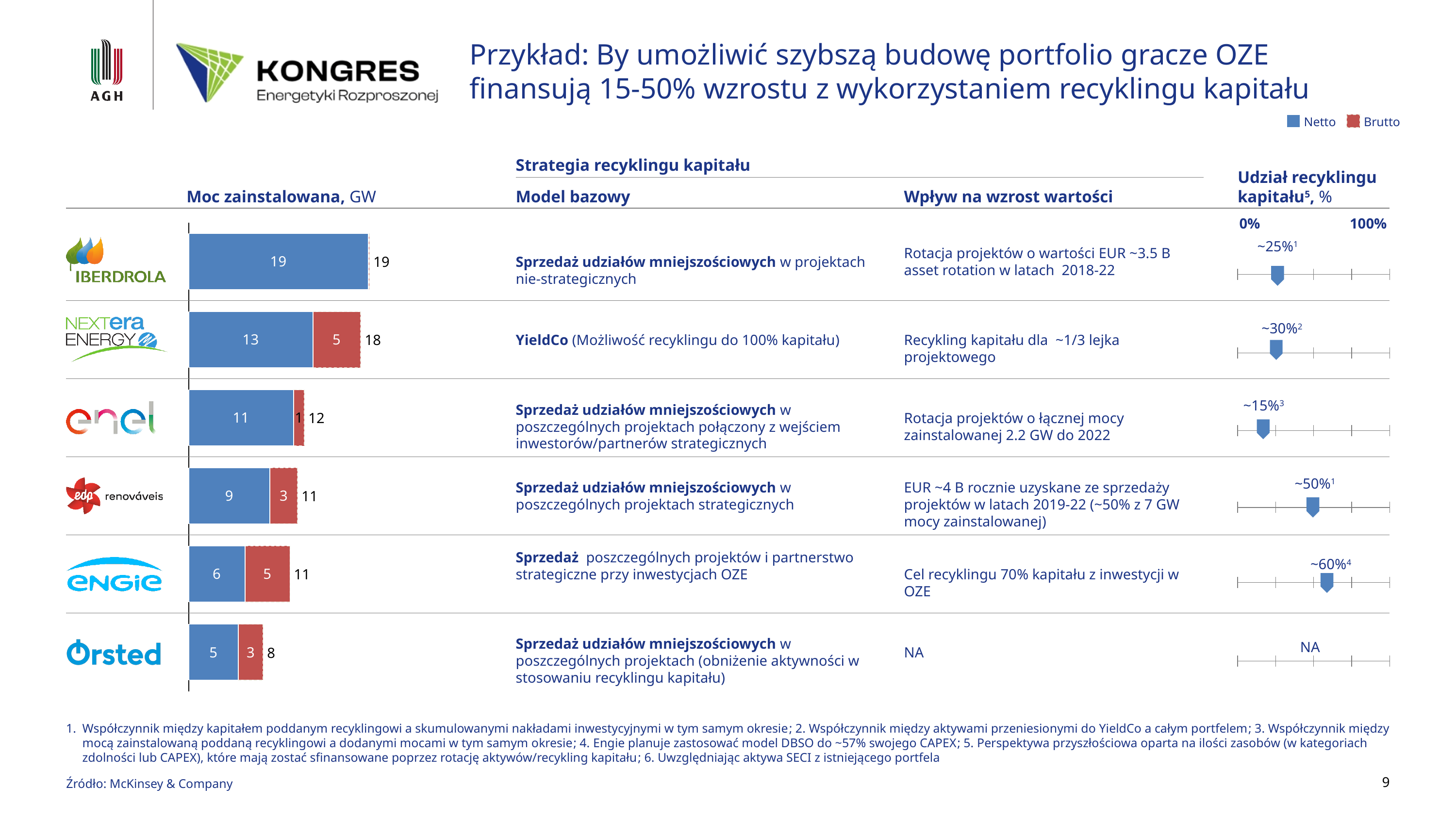
How many companies are shown in the 'Moc zainstalowana, GW' chart? 6 How many series does the legend of the 'Moc zainstalowana, GW' chart list? 2 In the 'Moc zainstalowana, GW' chart, what is the Netto value for Iberdrola? 19 In the 'Moc zainstalowana, GW' chart, which is larger: the Brutto value for EDP Renováveis or the Brutto value for Engie? Engie In the 'Moc zainstalowana, GW' chart, what is the Brutto value for NextEra Energy? 5 In the 'Moc zainstalowana, GW' chart, which company has the highest total installed capacity? Iberdrola In the 'Moc zainstalowana, GW' chart, what is the difference between the Netto values of NextEra Energy and Engie? 7 In the 'Moc zainstalowana, GW' chart, which colour represents the Brutto series? Red What kind of chart is used for 'Moc zainstalowana, GW'? Stacked bar chart In the 'Moc zainstalowana, GW' chart, what is the total installed capacity shown for Ørsted? 8 In the 'Moc zainstalowana, GW' chart, what is the Netto value for Enel? 11 In the 'Moc zainstalowana, GW' chart, which company has the lowest total installed capacity? Ørsted